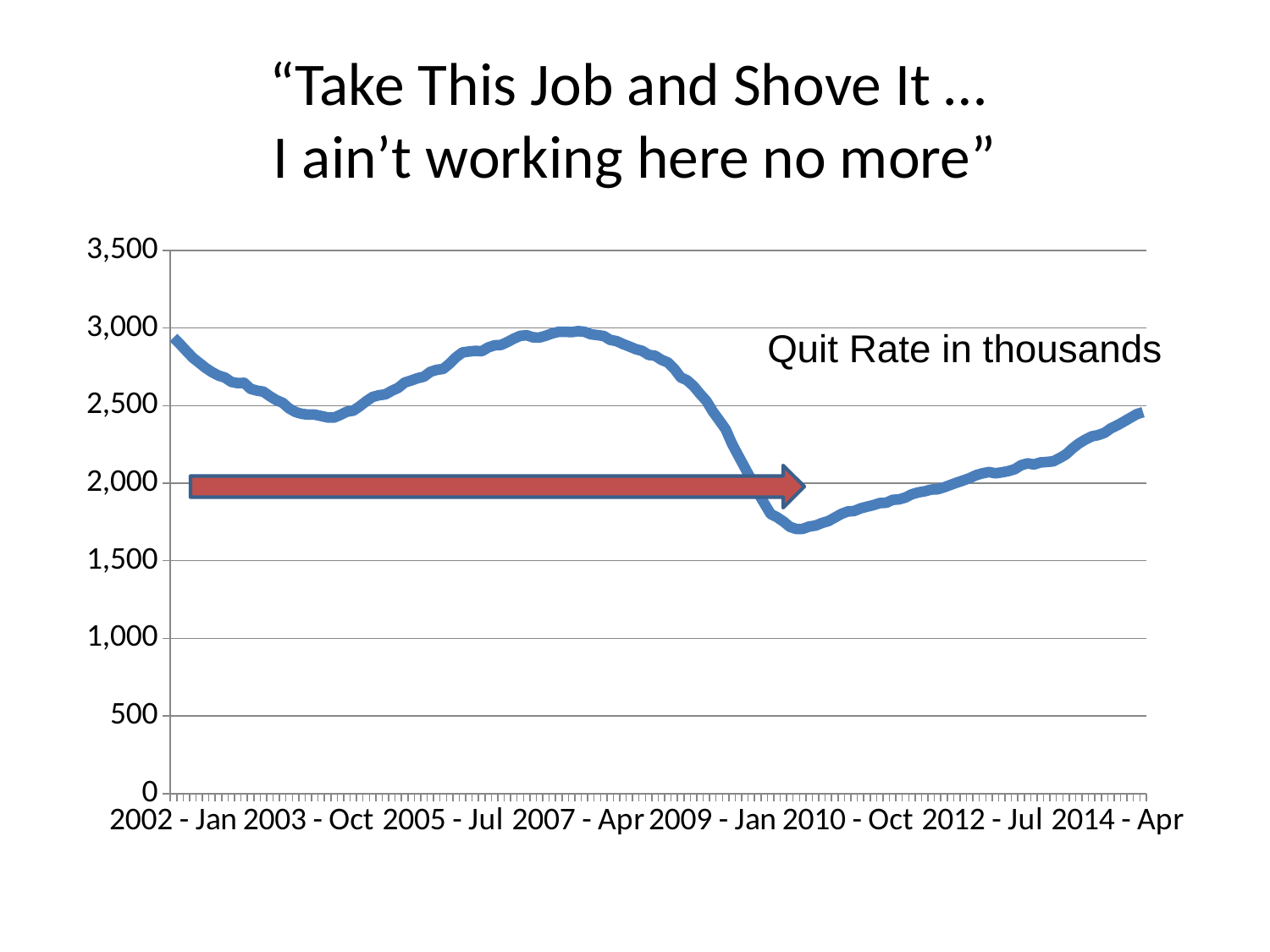
How many date labels are shown along the x axis of the chart? 8 Does the line ever fall below 1,500 on the chart? No Is the value for 2010 - Oct greater or less than 2,000? less Does the line rise or fall between 2010 - Oct and 2014 - Apr? rise Is the value for 2002 - Jan greater or less than 2,500? greater What is the title of the slide containing the chart? "Take This Job and Shove It … I ain't working here no more" What text label describes the data series plotted on the chart? Quit Rate in thousands What kind of chart is shown on the slide? line chart Does the line rise or fall between 2007 - Apr and 2010 - Oct? fall